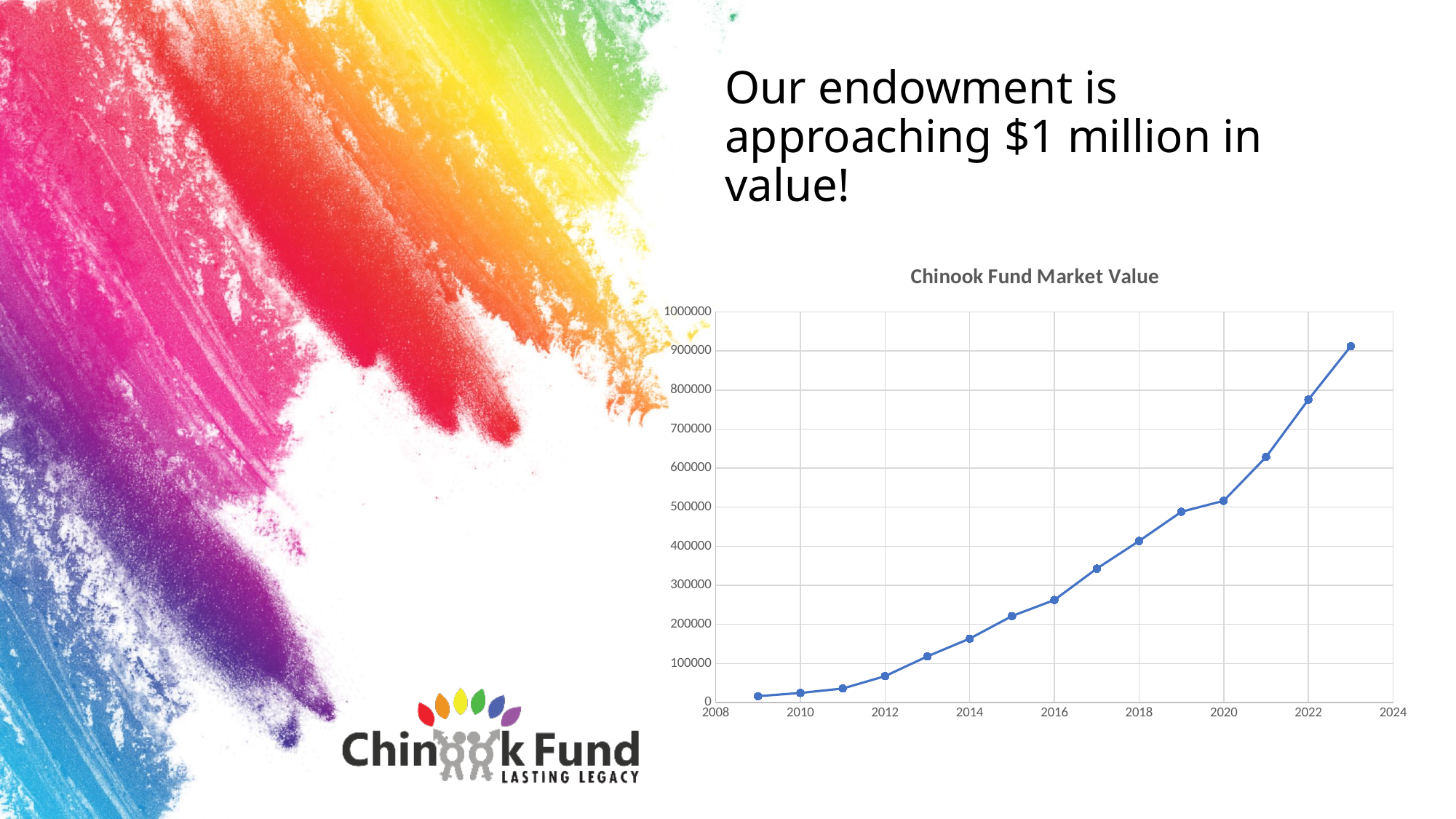
Which year has the highest market value in the chart? 2023 Which year has the lowest market value in the chart? 2009 Is the market value for 2023 greater or less than 800000? greater Do the market values rise or fall from 2009 to 2023? rise How many data points are plotted on the line? 15 Is the market value for 2021 greater or less than 600000? greater What kind of chart is shown on the slide? line chart Is the market value for 2014 greater or less than 100000? greater What is the title of the chart? Chinook Fund Market Value